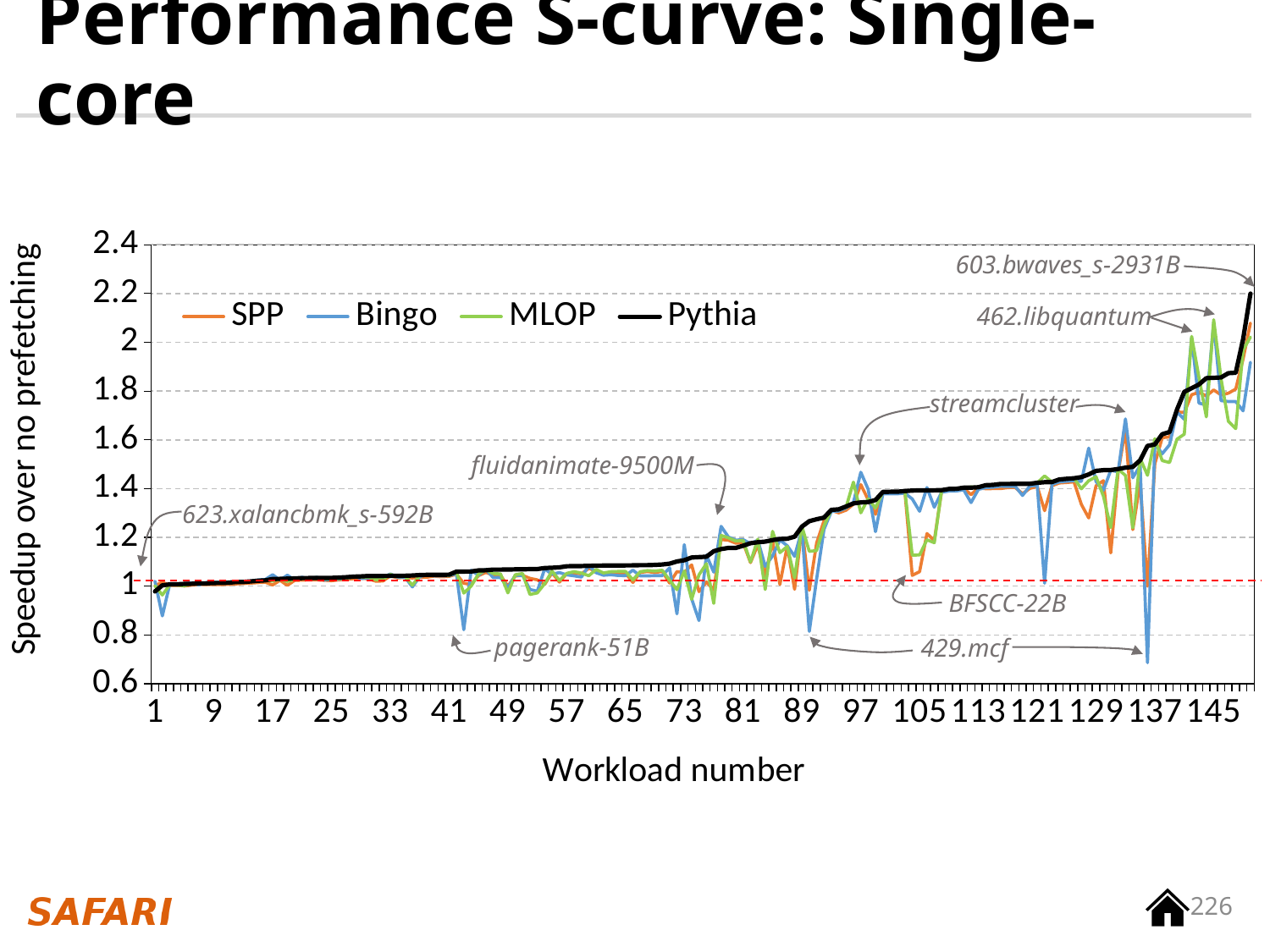
Is the Bingo value at the workload annotated pagerank-51B greater or less than 1? less Is the Pythia value at the highest workload number (annotated 603.bwaves_s-2931B) greater or less than 2? greater How many series does the legend list? 4 Which series reaches the lowest point on the chart, near workload 137? Bingo What is the title of the y axis? Speedup over no prefetching Which series is drawn as the thick black line? Pythia Is the Pythia value at workload number 1 greater or less than 1.2? less Does the Pythia line rise or fall as the workload number increases along the x axis? rise What kind of chart is shown on the slide? line chart Which series are listed in the legend? SPP, Bingo, MLOP, Pythia